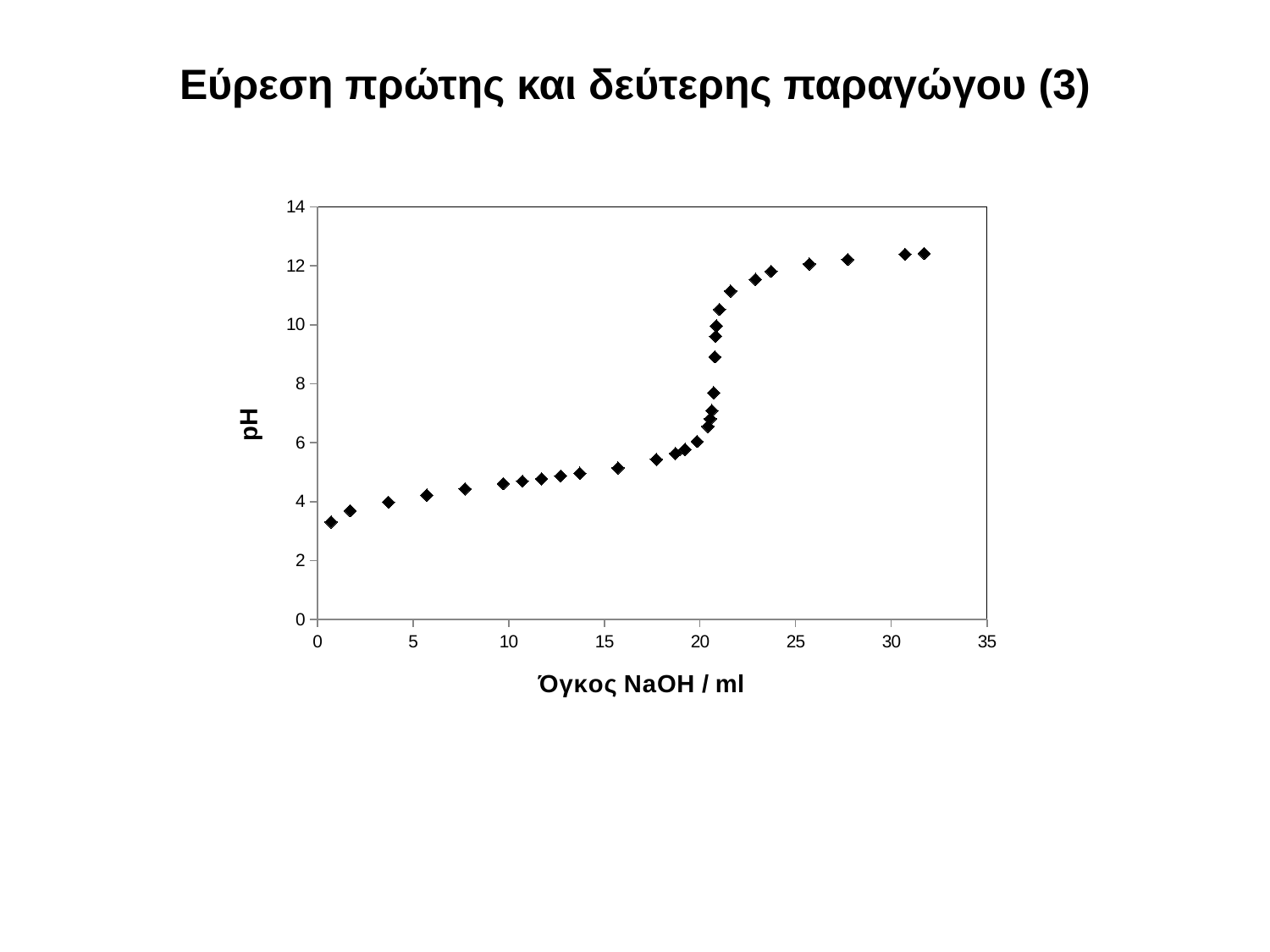
What is the label of the y axis? pH What is the label of the x axis? Όγκος NaOH / ml Does pH rise or fall as the volume of NaOH increases along the x axis? rise Around which volume of NaOH does the pH rise most steeply: about 10 ml or about 20 ml? about 20 ml What kind of chart is shown on the slide? scatter chart Is the pH at about 25 ml of NaOH greater or less than 10? greater Which data point has the lowest pH: the leftmost or the rightmost? the leftmost Is the pH of the rightmost data point greater or less than 12? greater Is the pH at about 15 ml of NaOH greater or less than 8? less